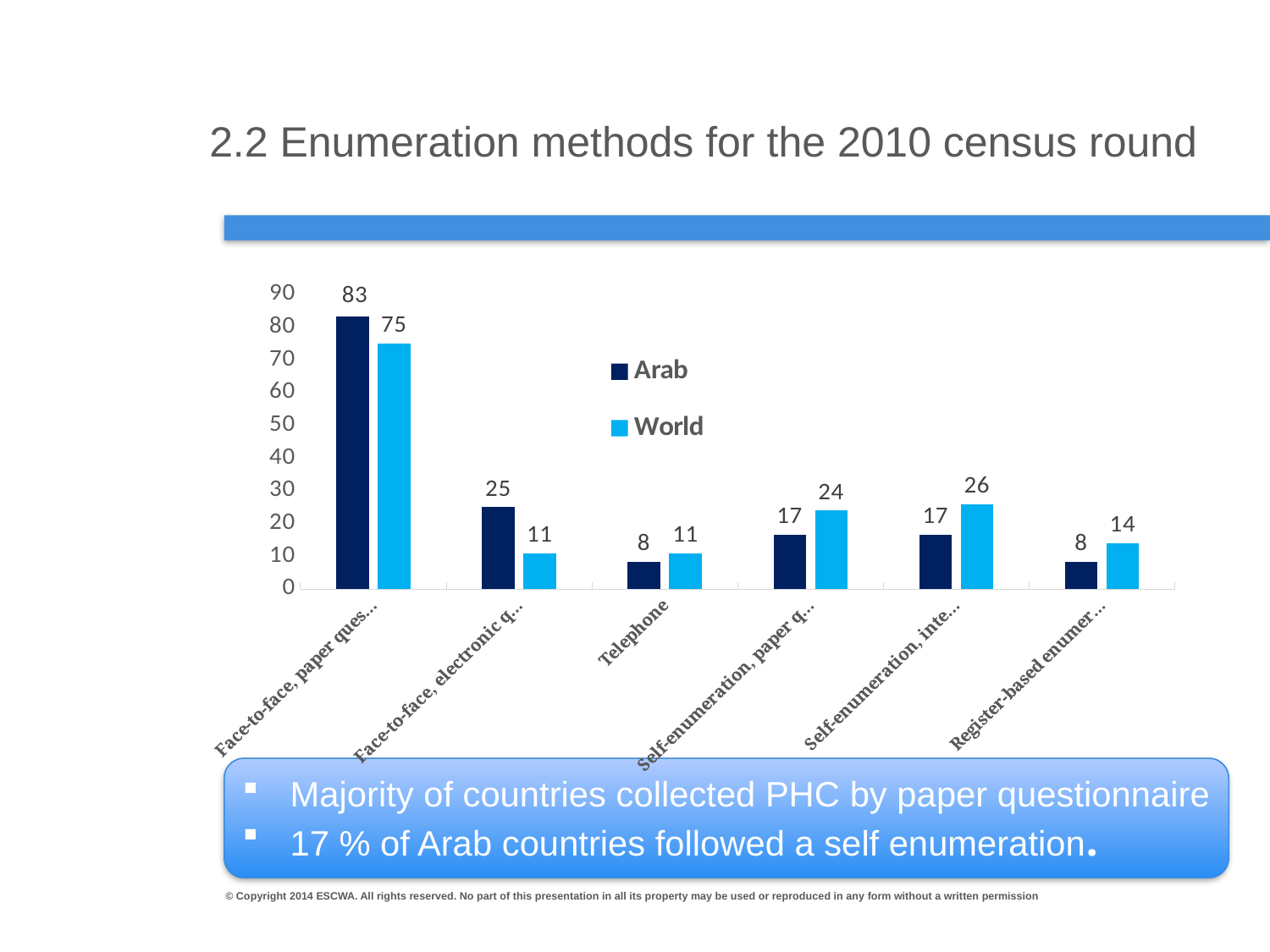
What kind of chart is shown on the slide? Bar chart What is the difference between the Arab and World values for the 'Face-to-face, paper' category? 8 How many categories are shown on the x axis? 6 Which category has the highest Arab value? Face-to-face, paper ques... What is the World value for the Telephone category? 11 What is the Arab value for the 'Face-to-face, paper' category? 83 Which category has the highest World value? Face-to-face, paper ques... What is the difference between the Arab and World values for the 'Face-to-face, electronic' category? 14 What is the Arab value for the Telephone category? 8 For the Telephone category, which is larger, the Arab value or the World value? World What is the World value for the 'Register-based enumer...' category? 14 How many series does the legend list? 2